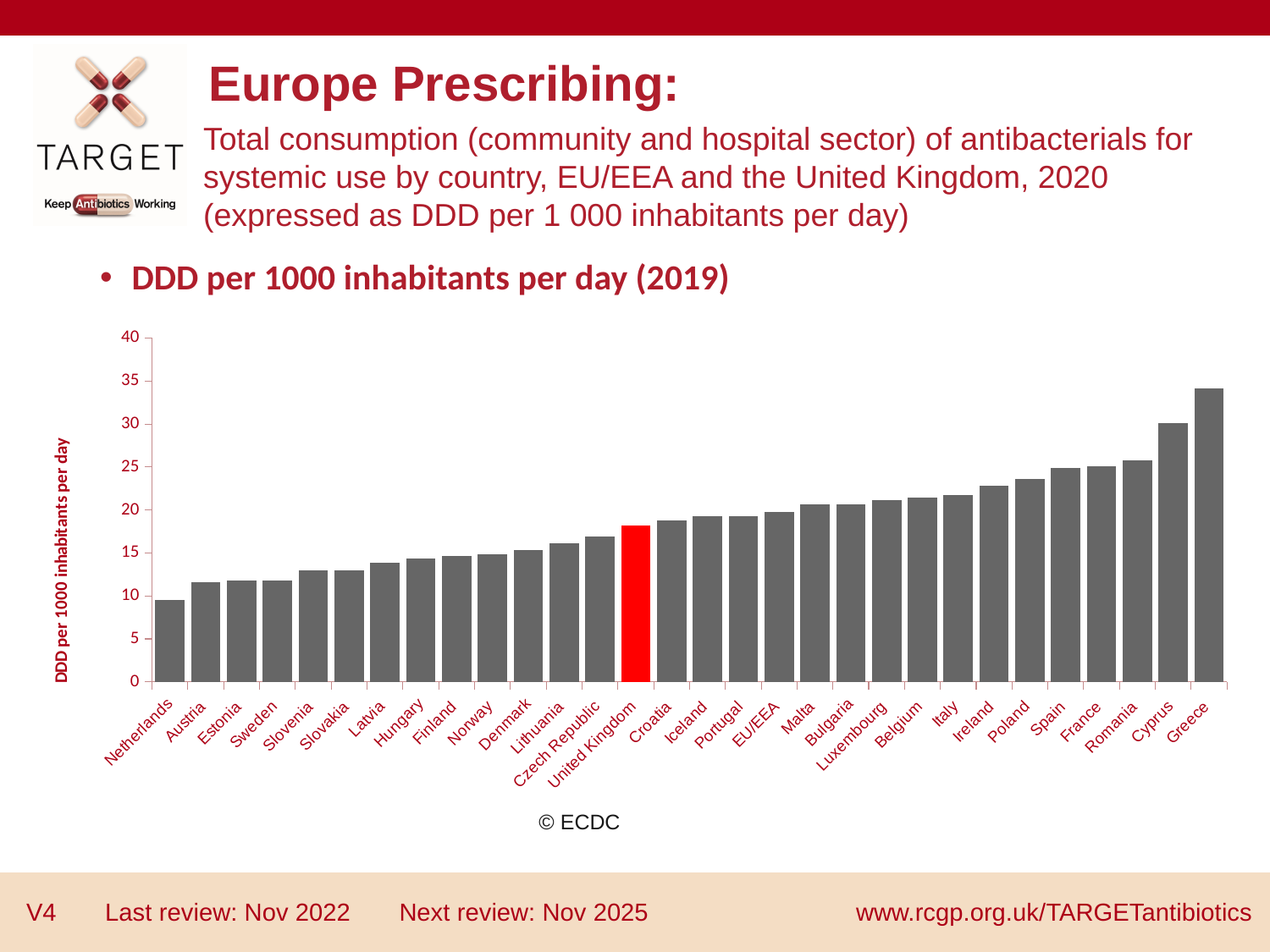
Is the value for Poland greater or less than 20? greater Which has the larger value, Greece or Cyprus? Greece Which bar is highlighted in red? United Kingdom Which country has the highest DDD per 1000 inhabitants per day? Greece Is the value for Cyprus greater or less than 35? less Do the values rise or fall moving from left to right along the x axis? rise Which country has the lowest DDD per 1000 inhabitants per day? Netherlands Is the value for the United Kingdom greater or less than 15? greater How many countries/regions are plotted on the x axis? 30 What kind of chart is shown on the slide? bar chart